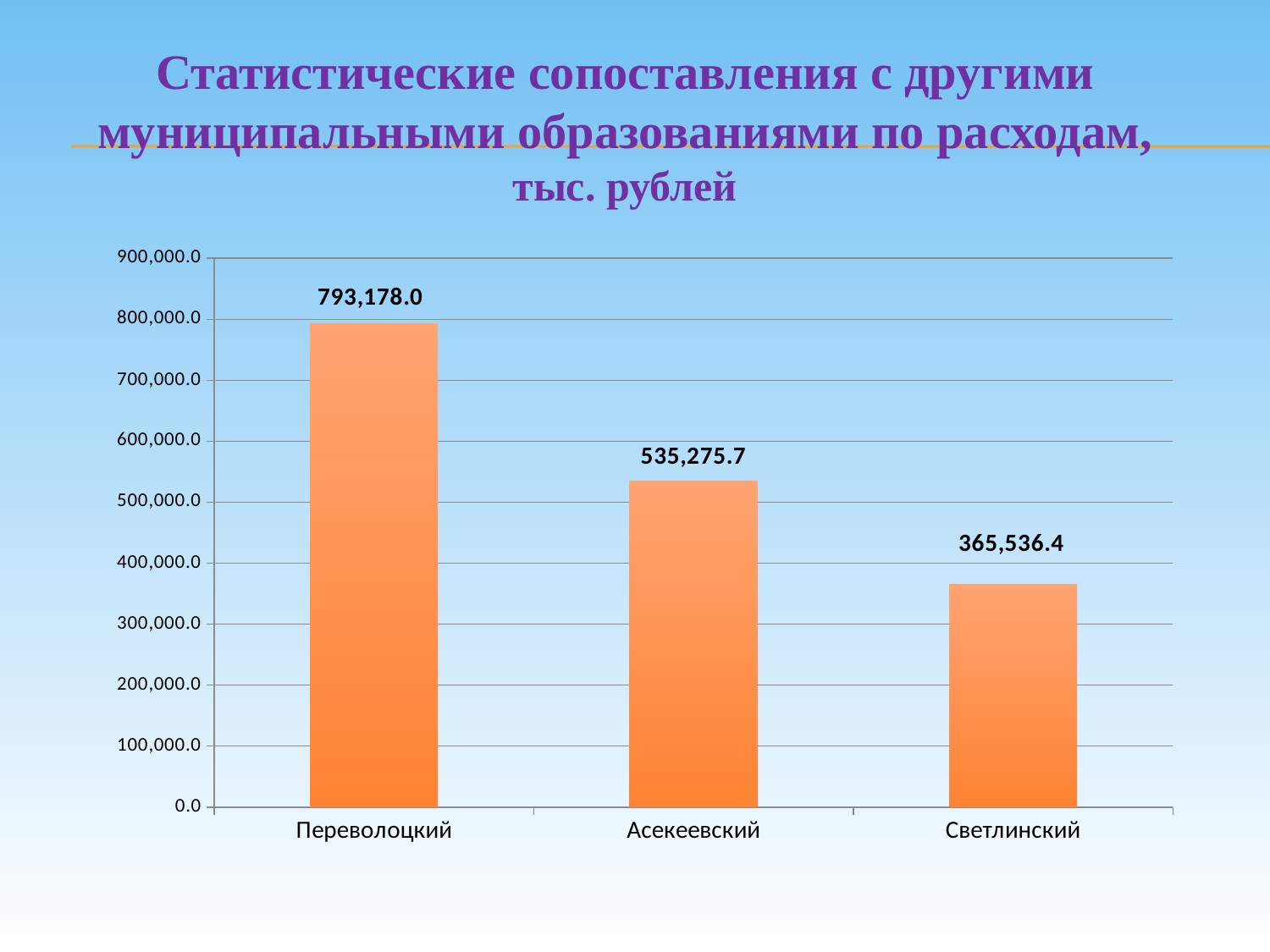
Which category has the lowest value? Светлинский Which category has the highest value? Переволоцкий Which is larger, the value for Асекеевский or the value for Светлинский? Асекеевский What is the value for Переволоцкий? 793,178.0 Do the values rise or fall from left to right along the x axis? fall Is the value for Светлинский greater or less than 400,000.0? less What is the difference between the values for Асекеевский and Светлинский? 169,739.3 What is the value for Асекеевский? 535,275.7 How many categories are shown on the x axis? 3 What is the value for Светлинский? 365,536.4 What is the difference between the values for Переволоцкий and Асекеевский? 257,902.3 What kind of chart is shown on the slide? bar chart